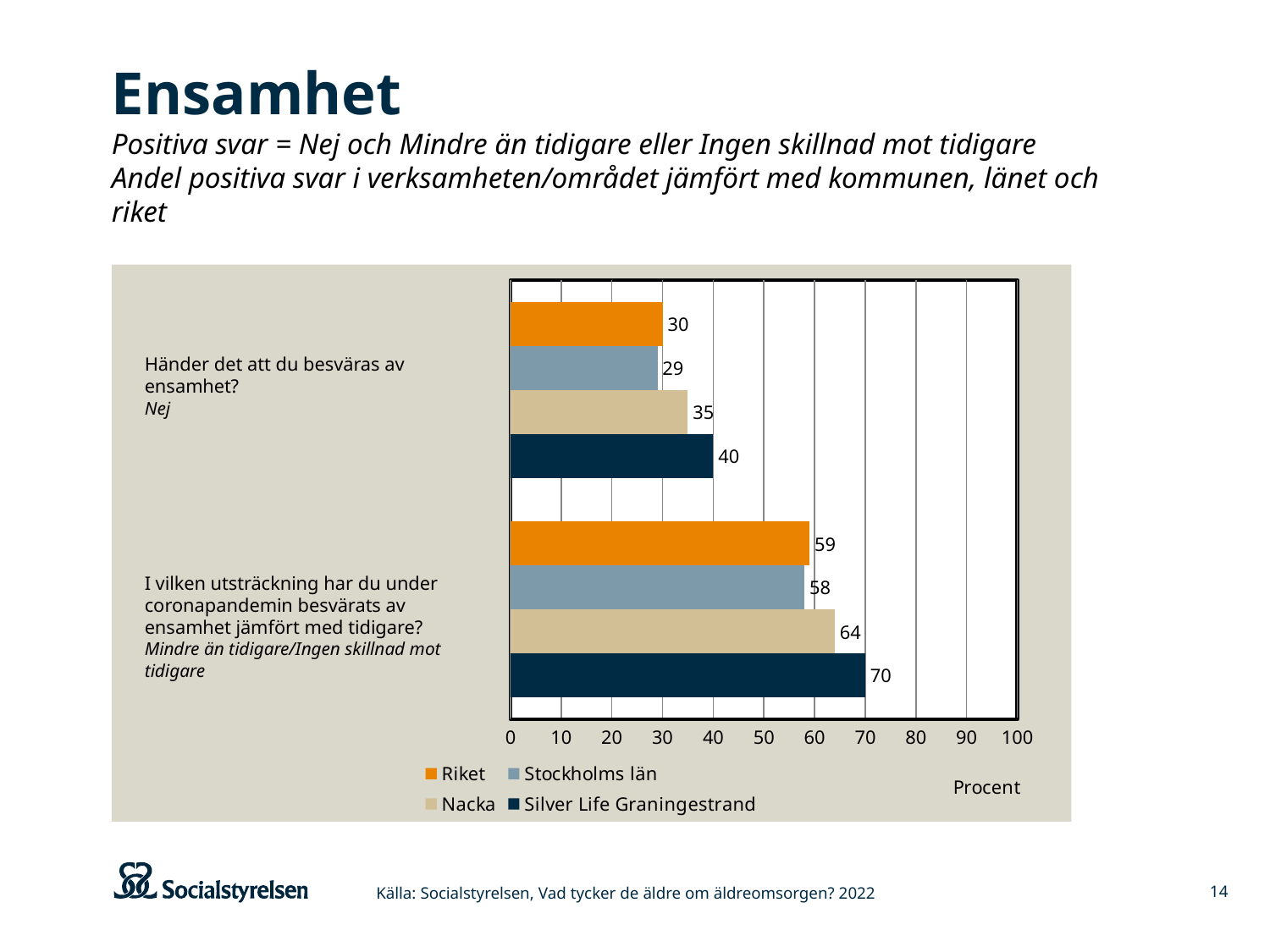
What is the difference between Nacka and Riket on the question 'Händer det att du besväras av ensamhet?'? 5 What is the value for Nacka on the question 'I vilken utsträckning har du under coronapandemin besvärats av ensamhet jämfört med tidigare?'? 64 Which series has the lowest value on the question 'Händer det att du besväras av ensamhet?'? Stockholms län What is the difference between Silver Life Graningestrand and Riket on the question 'I vilken utsträckning har du under coronapandemin besvärats av ensamhet jämfört med tidigare?'? 11 What is the value for Stockholms län on the question 'Händer det att du besväras av ensamhet?'? 29 Which is larger on the question 'Händer det att du besväras av ensamhet?': Nacka or Silver Life Graningestrand? Silver Life Graningestrand What kind of chart is shown on the slide? Bar chart Which series has the highest value on the question 'I vilken utsträckning har du under coronapandemin besvärats av ensamhet jämfört med tidigare?'? Silver Life Graningestrand How many series does the legend list? 4 What is the value for Silver Life Graningestrand on the question 'Händer det att du besväras av ensamhet?'? 40 What is the label of the x axis? Procent What is the value for Riket on the question 'I vilken utsträckning har du under coronapandemin besvärats av ensamhet jämfört med tidigare?'? 59